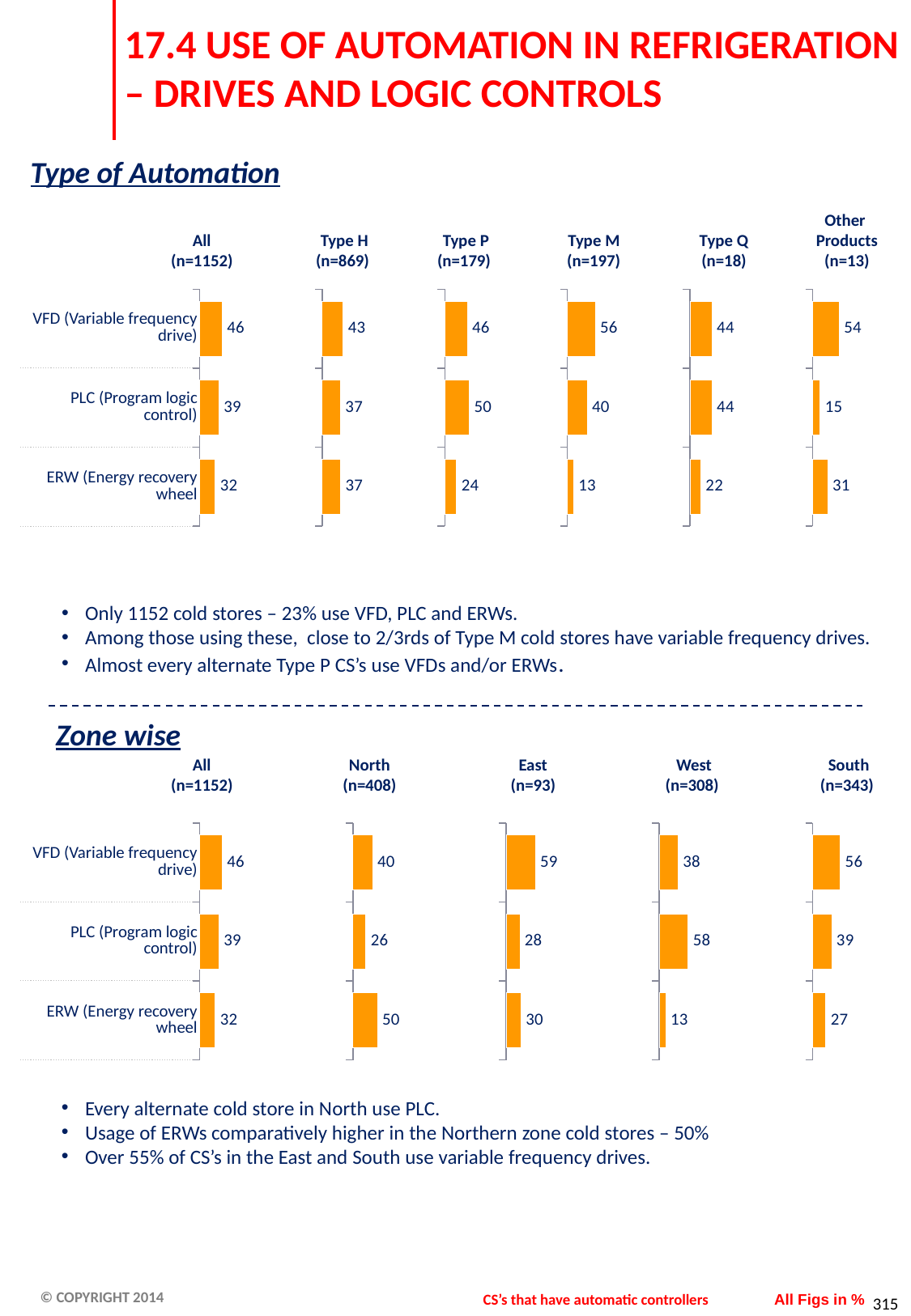
In the Type of Automation section, how many categories are shown in each chart? 3 In the Type of Automation section, what is the difference between the VFD and ERW values in the Type P (n=179) chart? 22 What type of chart is used in the Zone wise section? Bar chart In the Type of Automation section, what is the value for VFD (Variable frequency drive) in the Type M (n=197) chart? 56 In the Zone wise section, what is the value for ERW (Energy recovery wheel) in the North (n=408) chart? 50 In the Zone wise section, what is the difference between the VFD and ERW values in the South (n=343) chart? 29 In the Type of Automation section, what is the value for PLC (Program logic control) in the Other Products (n=13) chart? 15 In the Type of Automation section, which category has the lowest value in the Type M (n=197) chart? ERW (Energy recovery wheel) In the Type of Automation section, which category has the highest value in the Type P (n=179) chart? PLC (Program logic control) In the Zone wise section, which category has the highest value in the East (n=93) chart? VFD (Variable frequency drive) In the Zone wise section, is the VFD value larger in the East (n=93) chart or the West (n=308) chart? East (n=93) In the Zone wise section, what is the value for PLC (Program logic control) in the West (n=308) chart? 58